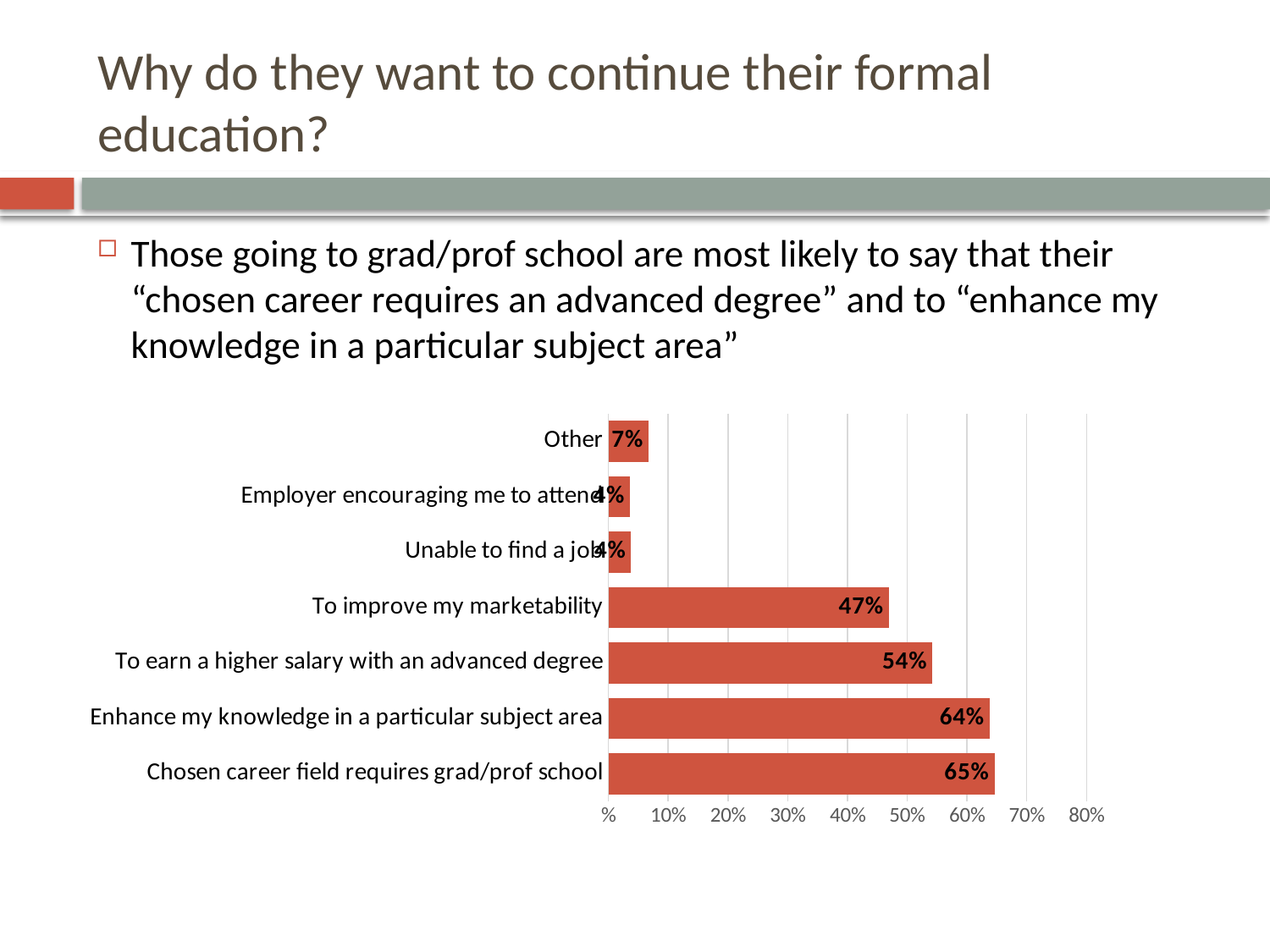
How many reasons (categories) are shown in the chart? 7 What is the value for "Other"? 7% What is the value for "To earn a higher salary with an advanced degree"? 54% What is the value for "To improve my marketability"? 47% What percentage of respondents said their chosen career field requires grad/prof school? 65% Which is larger: "To improve my marketability" or "To earn a higher salary with an advanced degree"? To earn a higher salary with an advanced degree What kind of chart is shown on the slide? Bar chart What is the difference between "Chosen career field requires grad/prof school" and "Other"? 58% What is the highest value shown on the x axis? 80% Which reason has the highest percentage? Chosen career field requires grad/prof school What is the difference between "Enhance my knowledge in a particular subject area" and "To earn a higher salary with an advanced degree"? 10% Is the value for "To improve my marketability" greater or less than 50%? less